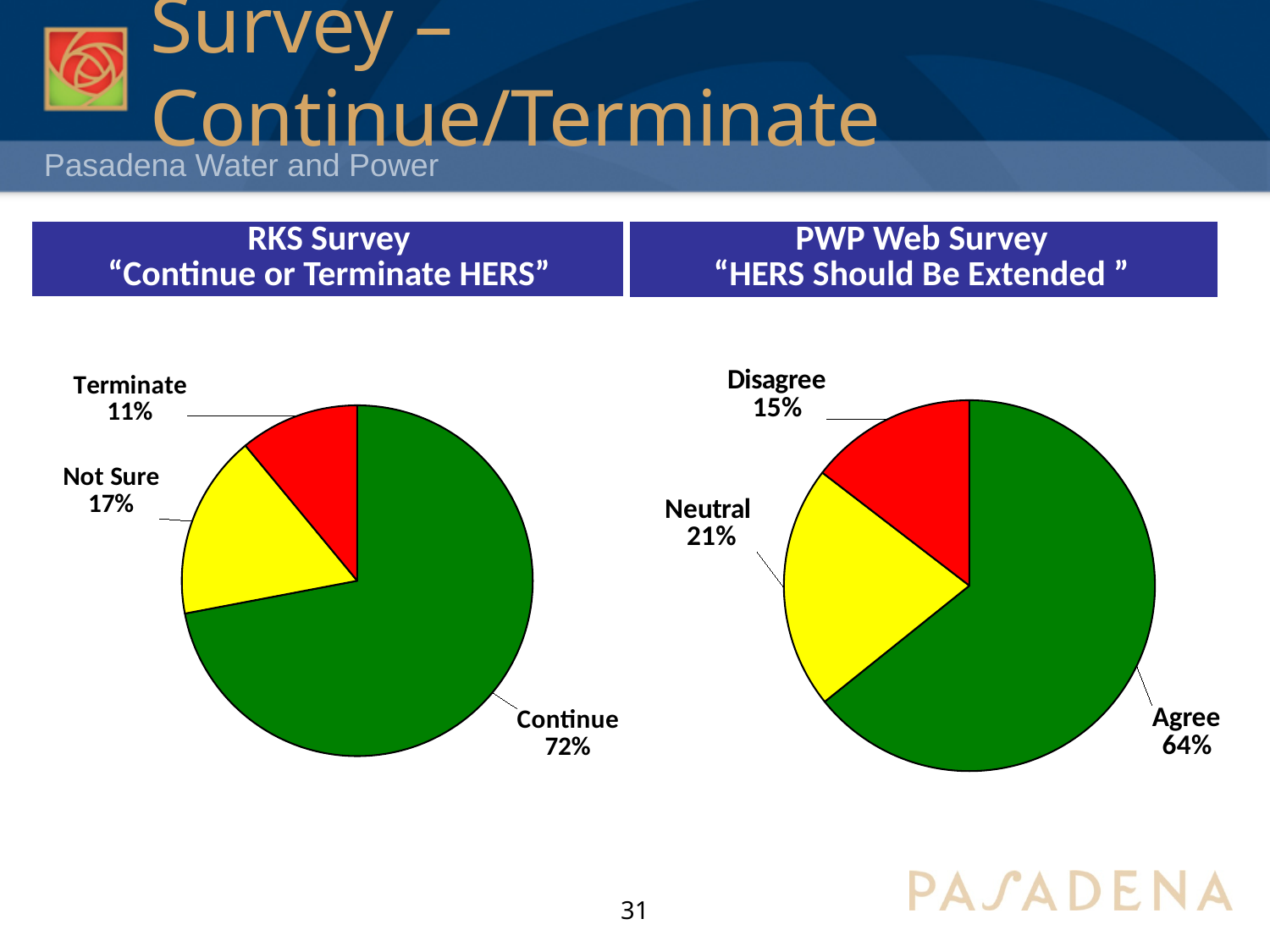
Which is larger: the Continue share in the RKS Survey chart or the Agree share in the PWP Web Survey chart? Continue in the RKS Survey chart In the PWP Web Survey pie chart, what is the difference between the Agree and Disagree percentages? 49% What type of chart is used for the RKS Survey on the left? Pie chart In the RKS Survey pie chart, what percentage of respondents chose Continue? 72% In the RKS Survey pie chart, what is the difference between the Not Sure and Terminate percentages? 6% In the PWP Web Survey pie chart, what colour is the Disagree slice? Red In the RKS Survey pie chart, what percentage of respondents chose Terminate? 11% In the PWP Web Survey pie chart, what share is labelled Agree? 64% In the RKS Survey pie chart, which category has the smallest slice? Terminate In the PWP Web Survey pie chart, which category has the largest slice? Agree In the PWP Web Survey pie chart, what share is labelled Neutral? 21% How many slices does the PWP Web Survey pie chart have? 3